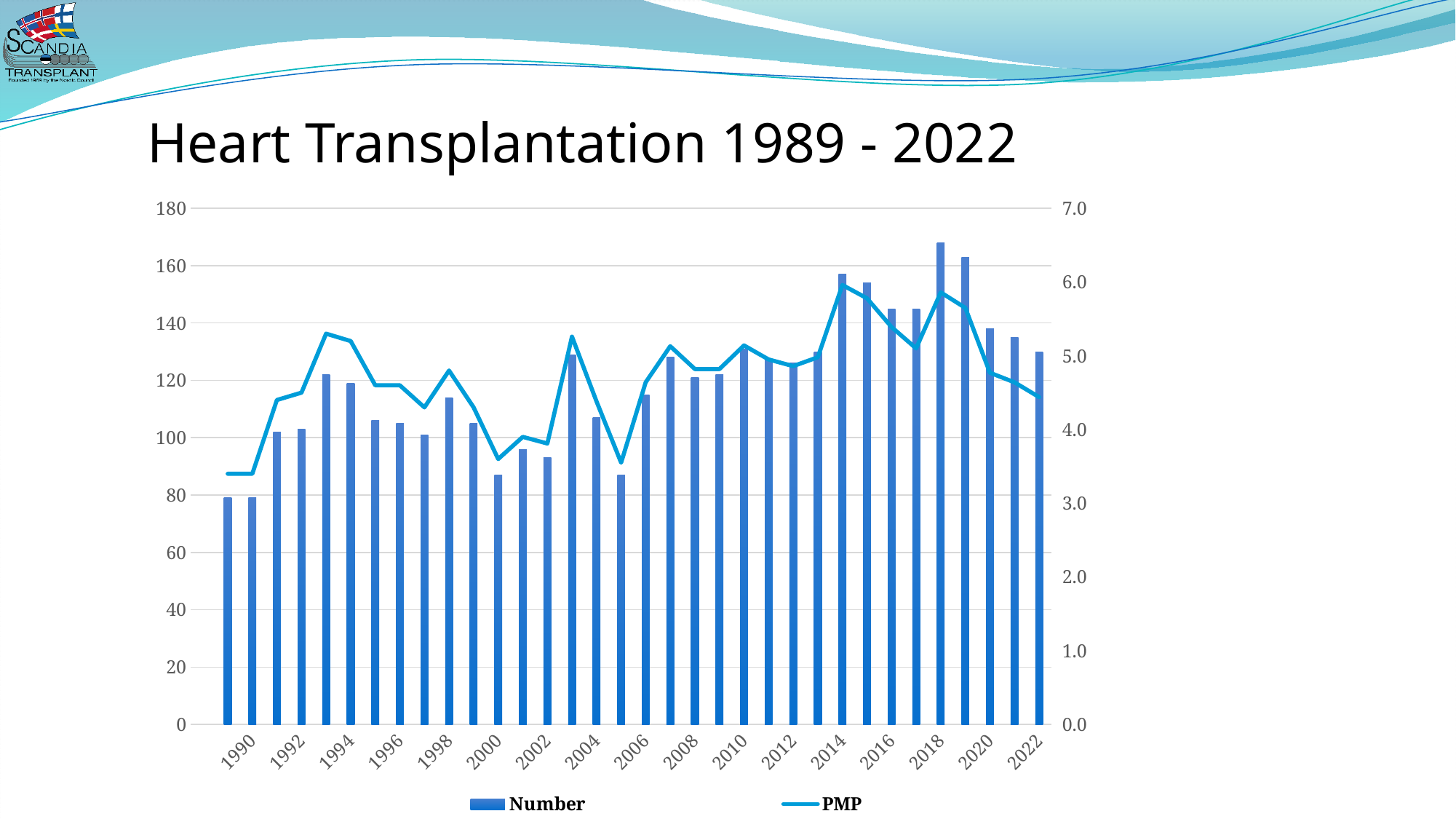
Is the PMP value for 1990 greater or less than 4.0? less How many series does the legend list? 2 Is the Number bar for 2018 greater or less than 160? greater Which year has the highest bar for Number? 2018 Is the Number bar for 2022 greater or less than 120? greater What is the title of the slide containing the chart? Heart Transplantation 1989 - 2022 What are the two series named in the legend? Number and PMP What kind of chart is shown on the slide? A combined bar and line chart Which year has the larger Number bar, 2014 or 2000? 2014 Overall, do the Number bars rise or fall from 1989 to 2022? rise